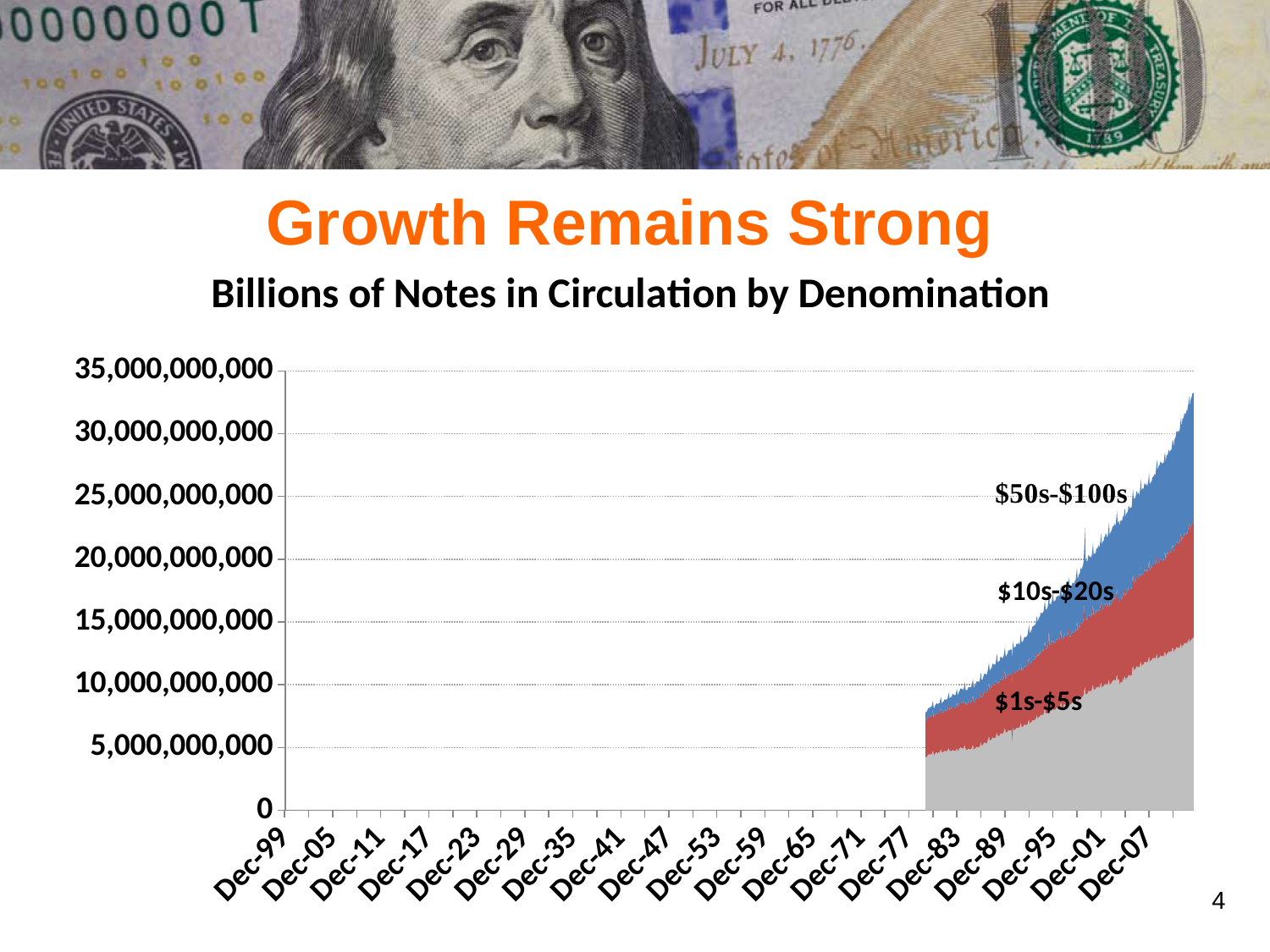
Which denomination series accounts for the largest number of notes at the right end of the chart? $1s-$5s Which is larger at the right end of the chart: the $1s-$5s series or the $10s-$20s series? $1s-$5s What is the subtitle describing the chart's data? Billions of Notes in Circulation by Denomination Is the total number of notes in circulation at the right end of the chart greater or less than 30,000,000,000? greater How many denomination series are plotted in the chart? 3 Does the total number of notes in circulation rise or fall over time along the x axis? Rise Which denomination series is shown in blue at the top of the stack? $50s-$100s What is the highest value shown on the y axis? 35,000,000,000 How many date labels are shown along the x axis? 19 Is the total number of notes at the start of the plotted data (around Dec-80) greater or less than 10,000,000,000? less Is the $1s-$5s series at the right end of the chart greater or less than 10,000,000,000? greater What kind of chart is shown on the slide? Stacked area chart